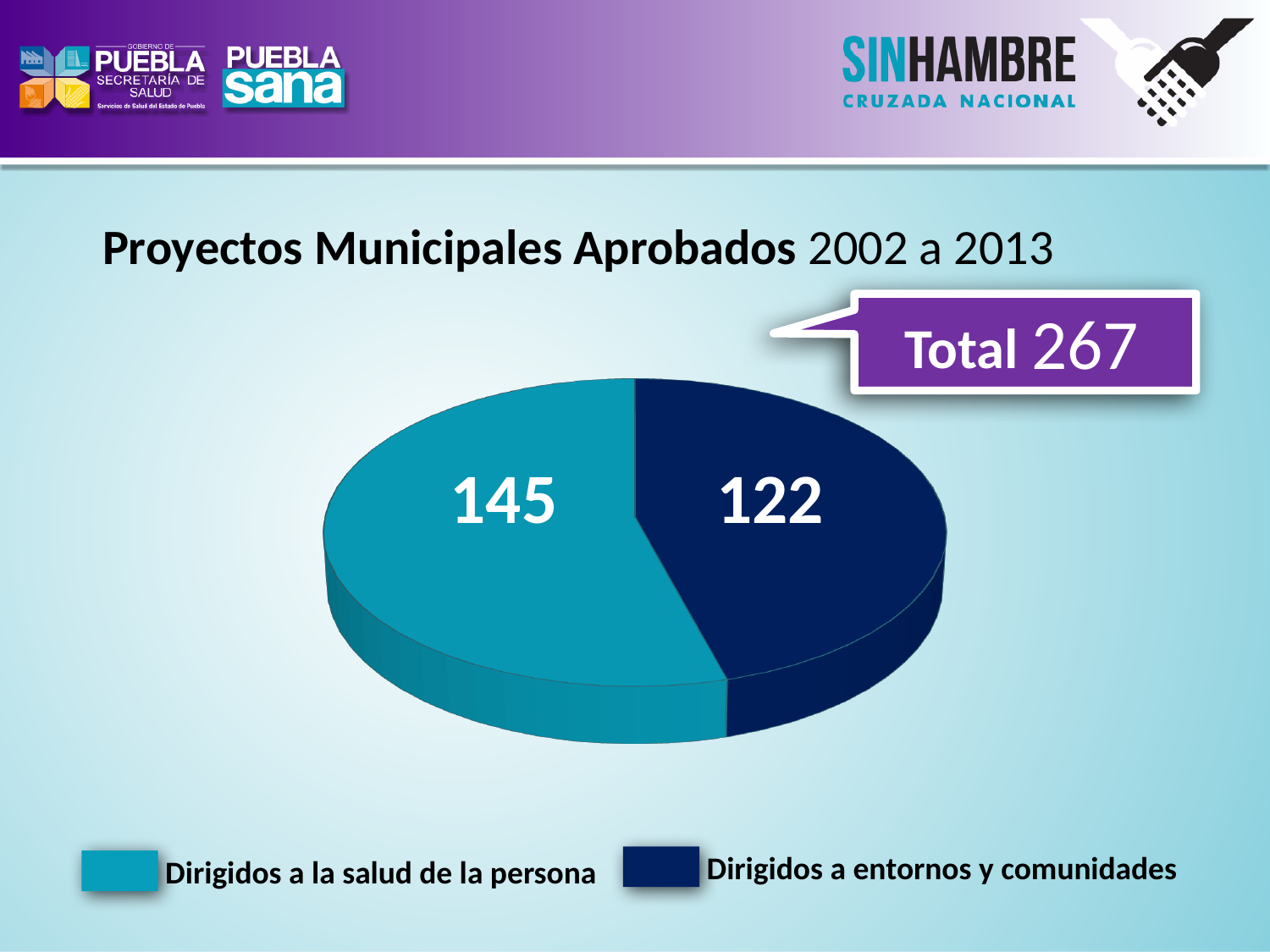
What is the total of all slices in the pie chart? 267 What is the difference between the values for 'Dirigidos a la salud de la persona' and 'Dirigidos a entornos y comunidades'? 23 What type of chart is shown on the slide? Pie chart What is the value for 'Dirigidos a entornos y comunidades'? 122 What is the title of the chart? Proyectos Municipales Aprobados 2002 a 2013 Which category has the highest value? Dirigidos a la salud de la persona What colour is the slice for 'Dirigidos a entornos y comunidades'? Dark blue Which is larger: 'Dirigidos a la salud de la persona' or 'Dirigidos a entornos y comunidades'? Dirigidos a la salud de la persona What is the value for 'Dirigidos a la salud de la persona'? 145 How many slices does the pie chart have? 2 Which category has the lowest value? Dirigidos a entornos y comunidades